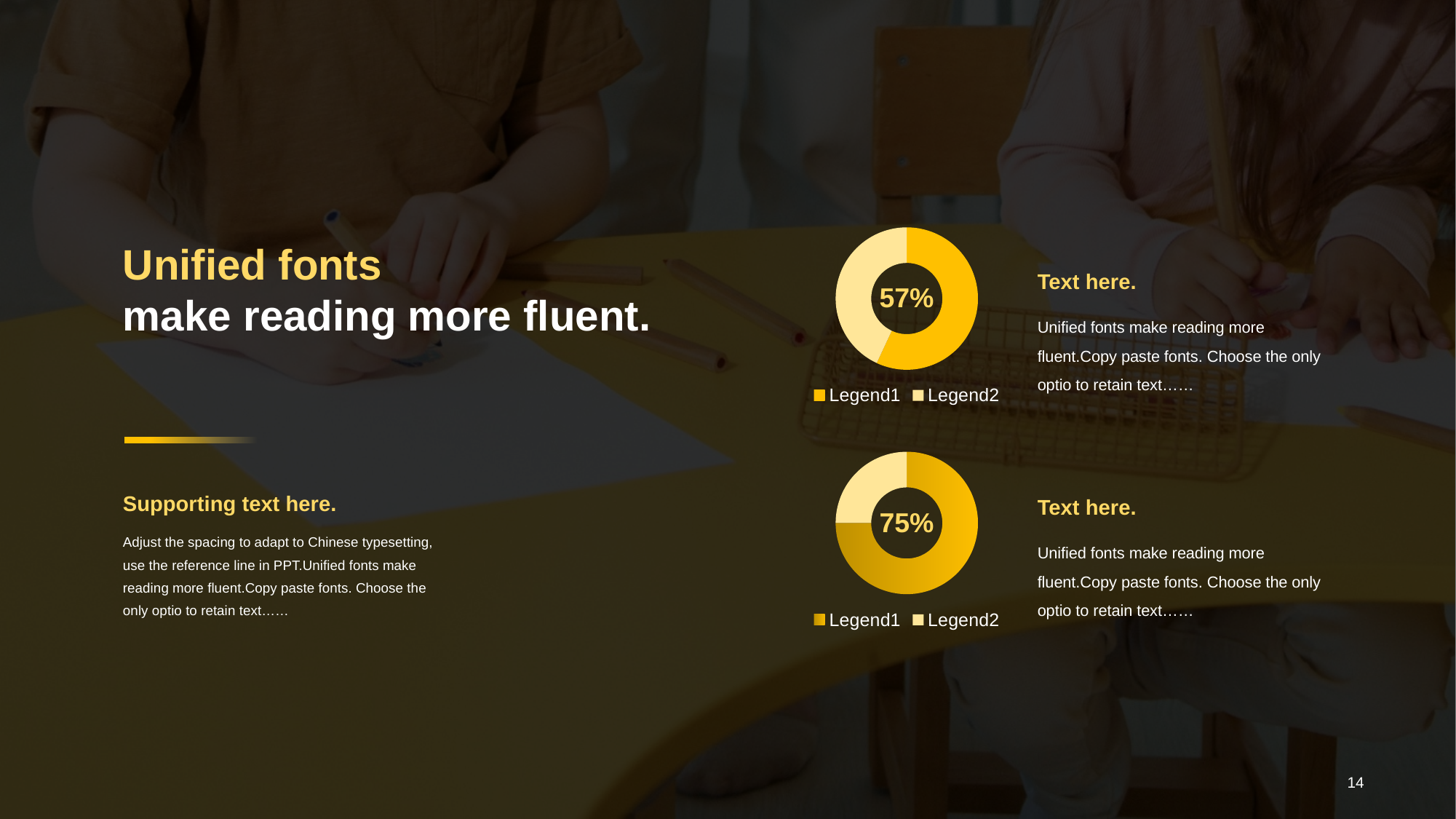
In the top chart, what percentage is displayed in the centre of the doughnut? 57% In the bottom chart, what percentage is displayed in the centre of the doughnut? 75% In the top chart, which slice is larger, Legend1 or Legend2? Legend1 In the bottom chart, which slice is the smallest? Legend2 In the bottom chart, which slice is larger, Legend1 or Legend2? Legend1 Which chart shows the larger centre percentage, the top chart or the bottom chart? the bottom chart How many slices does the top doughnut chart have? 2 How many entries does the legend of the bottom chart list? 2 How many entries does the legend of the top chart list? 2 What kind of chart is the bottom chart on the slide? doughnut chart What kind of chart is the top chart on the slide? doughnut chart What are the legend entries of the bottom chart? Legend1, Legend2